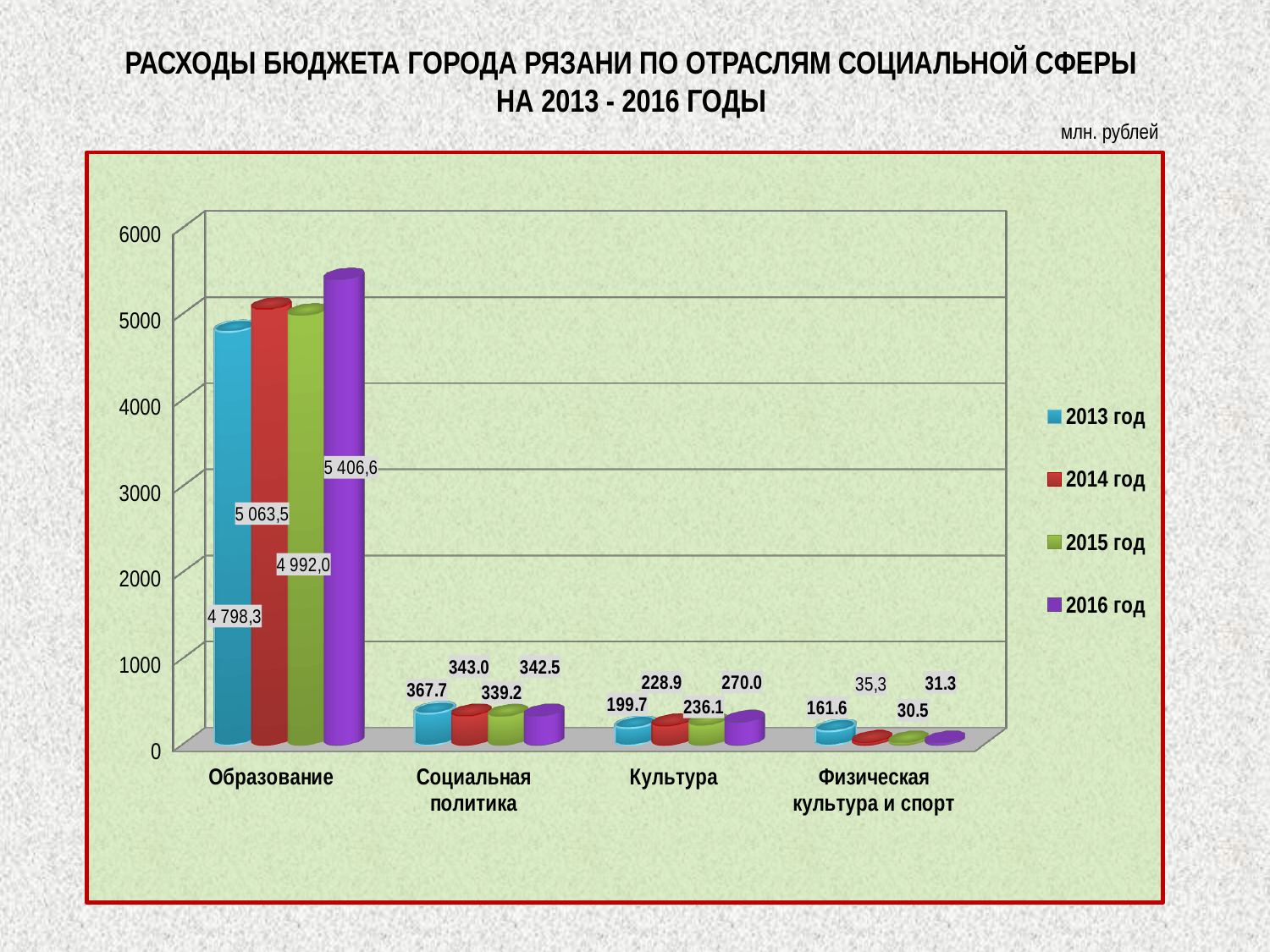
What is the value for Культура in 2015 год? 236.1 Which year has the lowest value for Физическая культура и спорт? 2015 год What is the value for Физическая культура и спорт in 2014 год? 35,3 What type of chart is shown on the slide? bar chart What is the value for Социальная политика in 2013 год? 367.7 How many series does the legend list? 4 Which is larger for Образование: the 2014 год value or the 2015 год value? 2014 год Which category has the highest values across all years? Образование Do the values for Культура rise or fall from 2013 год to 2016 год? rise How many categories are shown on the x axis? 4 What is the value for Образование in 2016 год? 5 406,6 What is the difference between the 2016 год and 2013 год values for Культура? 70.3